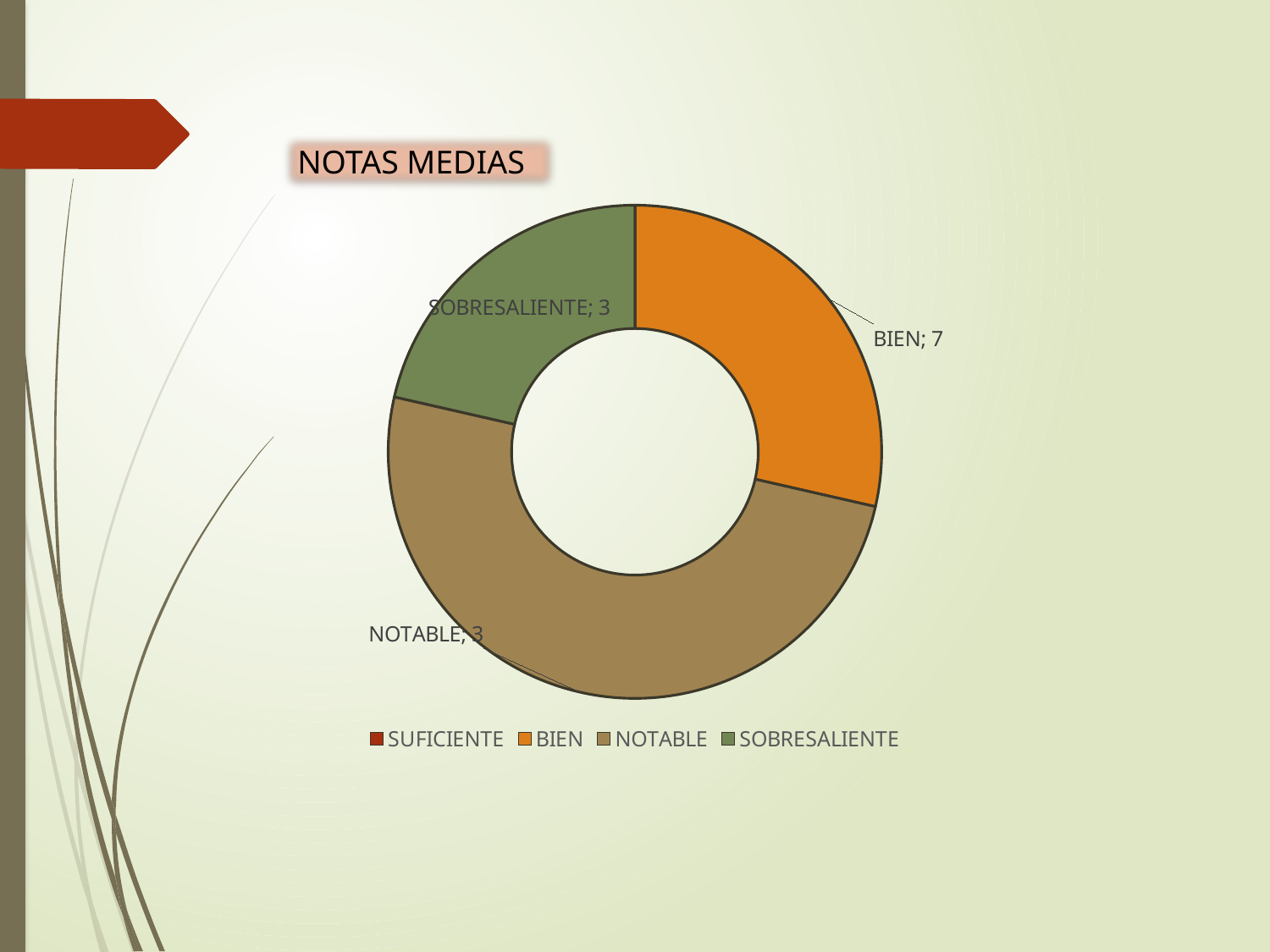
Which legend entry has no visible slice in the chart? SUFICIENTE What is the title of the chart? NOTAS MEDIAS Which has the larger value, BIEN or SOBRESALIENTE? BIEN How many entries does the legend list? 4 What is the value shown for SOBRESALIENTE in the NOTAS MEDIAS chart? 3 What kind of chart is shown on the slide? Doughnut (pie) chart How many slices are visible in the doughnut chart? 3